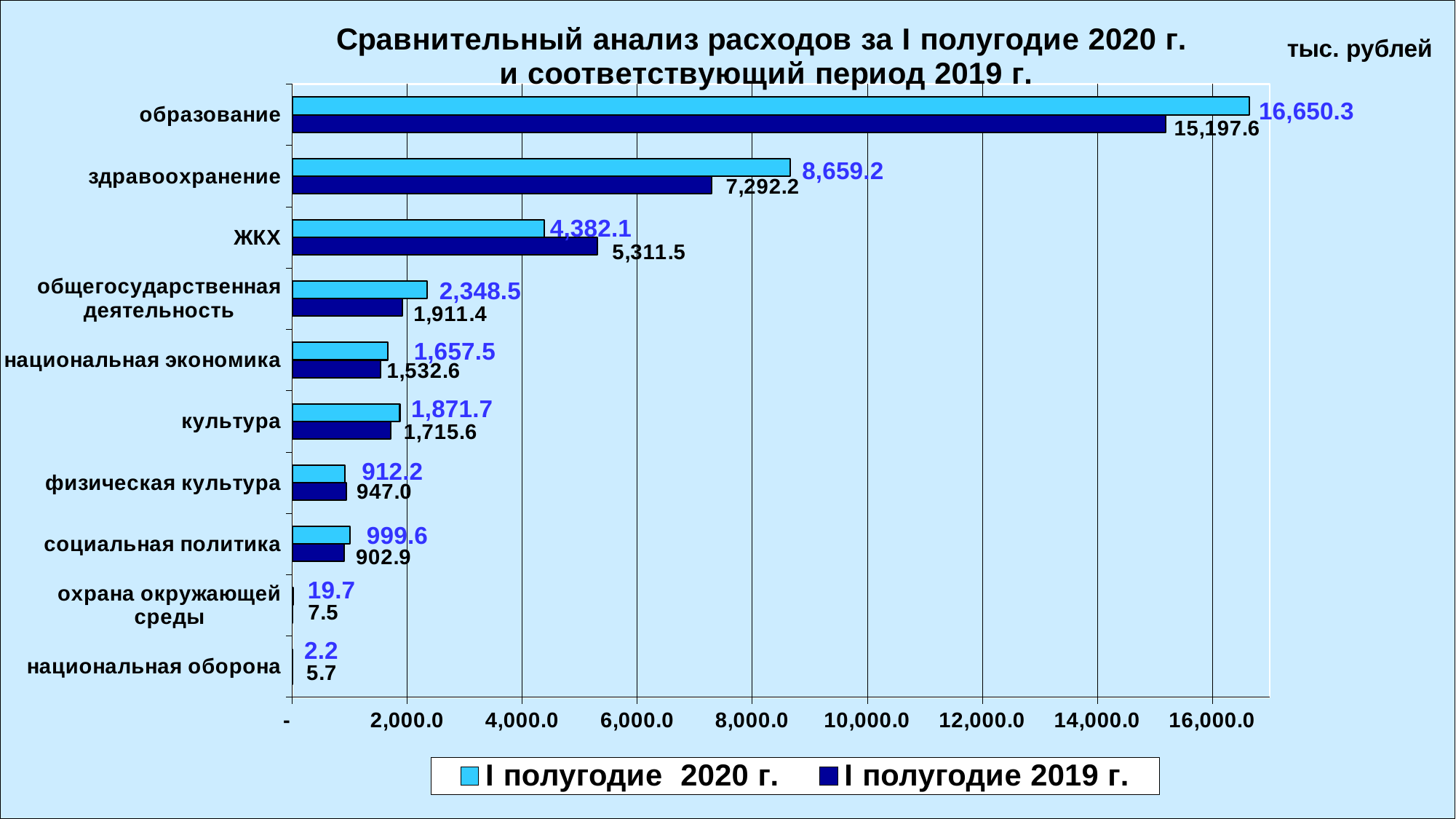
Which category has the highest value in I полугодие 2020 г.? образование What is the value for ЖКХ in I полугодие 2019 г.? 5,311.5 What unit is indicated in the top right corner of the chart? тыс. рублей For ЖКХ, which is larger: the I полугодие 2020 г. value or the I полугодие 2019 г. value? I полугодие 2019 г. What is the difference between the I полугодие 2020 г. and I полугодие 2019 г. values for образование? 1,452.7 Is the value for здравоохранение in I полугодие 2019 г. greater or less than 8,000.0? less Which category has the lowest value in I полугодие 2020 г.? национальная оборона What is the value for образование in I полугодие 2020 г.? 16,650.3 How many series does the legend list? 2 What kind of chart is shown on the slide? bar chart How many categories are shown on the chart? 10 What is the value for социальная политика in I полугодие 2020 г.? 999.6